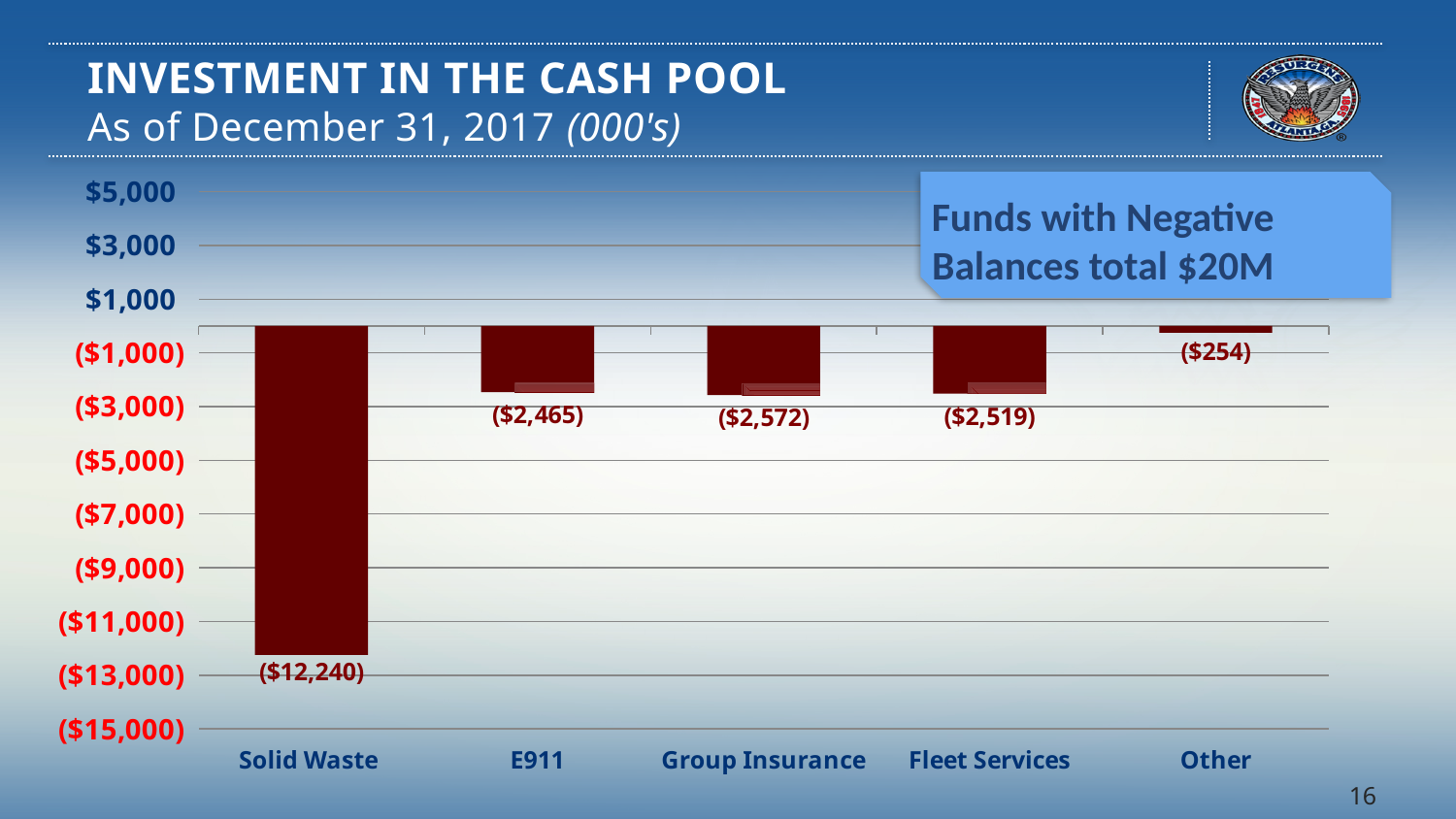
How many categories are shown on the x axis? 5 Which category has the largest negative balance? Solid Waste What is the value shown for Other? ($254) Is the value for Solid Waste greater or less than ($11,000)? less Which category has the smallest negative balance? Other What kind of chart is shown on the slide? bar chart By how much does the negative balance of Solid Waste exceed that of E911? $9,775 What is the value shown for E911? ($2,465) What is the value shown for Group Insurance? ($2,572) What is the value shown for Fleet Services? ($2,519) What is the value shown for Solid Waste? ($12,240) Which has the larger negative balance, Group Insurance or Fleet Services? Group Insurance